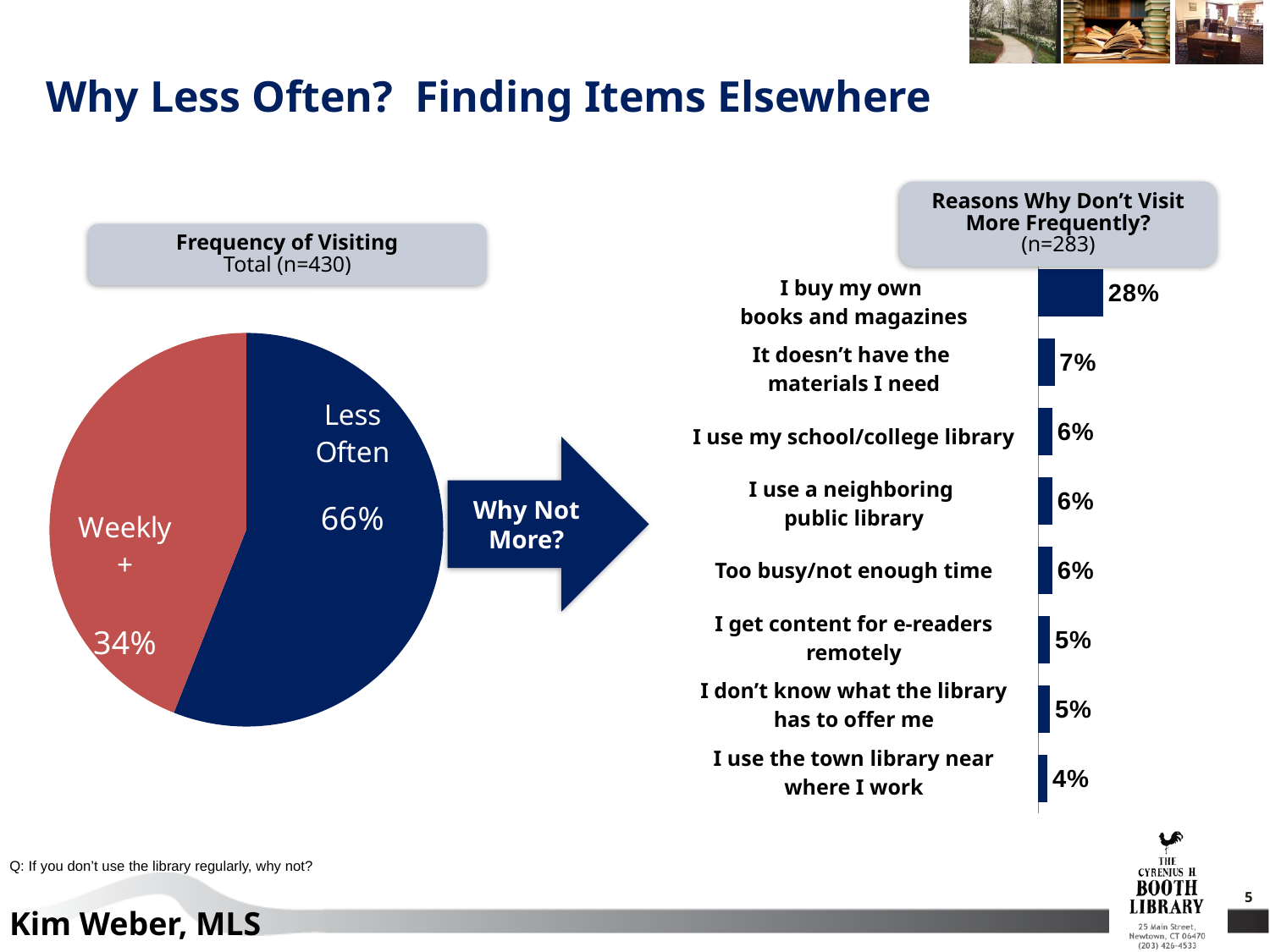
In the Reasons Why Don't Visit More Frequently chart, what is the value for 'I use the town library near where I work'? 4% In the Frequency of Visiting pie chart, what is the total sample size shown in the title? n=430 In the Reasons Why Don't Visit More Frequently chart, how many reasons are listed? 8 In the Frequency of Visiting pie chart, what share of respondents visit Weekly +? 34% What kind of chart is the Reasons Why Don't Visit More Frequently chart? Bar chart In the Frequency of Visiting pie chart, what share of respondents visit Less Often? 66% What kind of chart is the Frequency of Visiting chart? Pie chart In the Reasons Why Don't Visit More Frequently chart, what is the difference between 'I buy my own books and magazines' and 'It doesn't have the materials I need'? 21% In the Reasons Why Don't Visit More Frequently chart, what is the value for 'It doesn't have the materials I need'? 7% In the Reasons Why Don't Visit More Frequently chart, what is the value for 'I buy my own books and magazines'? 28% In the Reasons Why Don't Visit More Frequently chart, which reason has the lowest value? I use the town library near where I work In the Reasons Why Don't Visit More Frequently chart, which reason has the highest value? I buy my own books and magazines